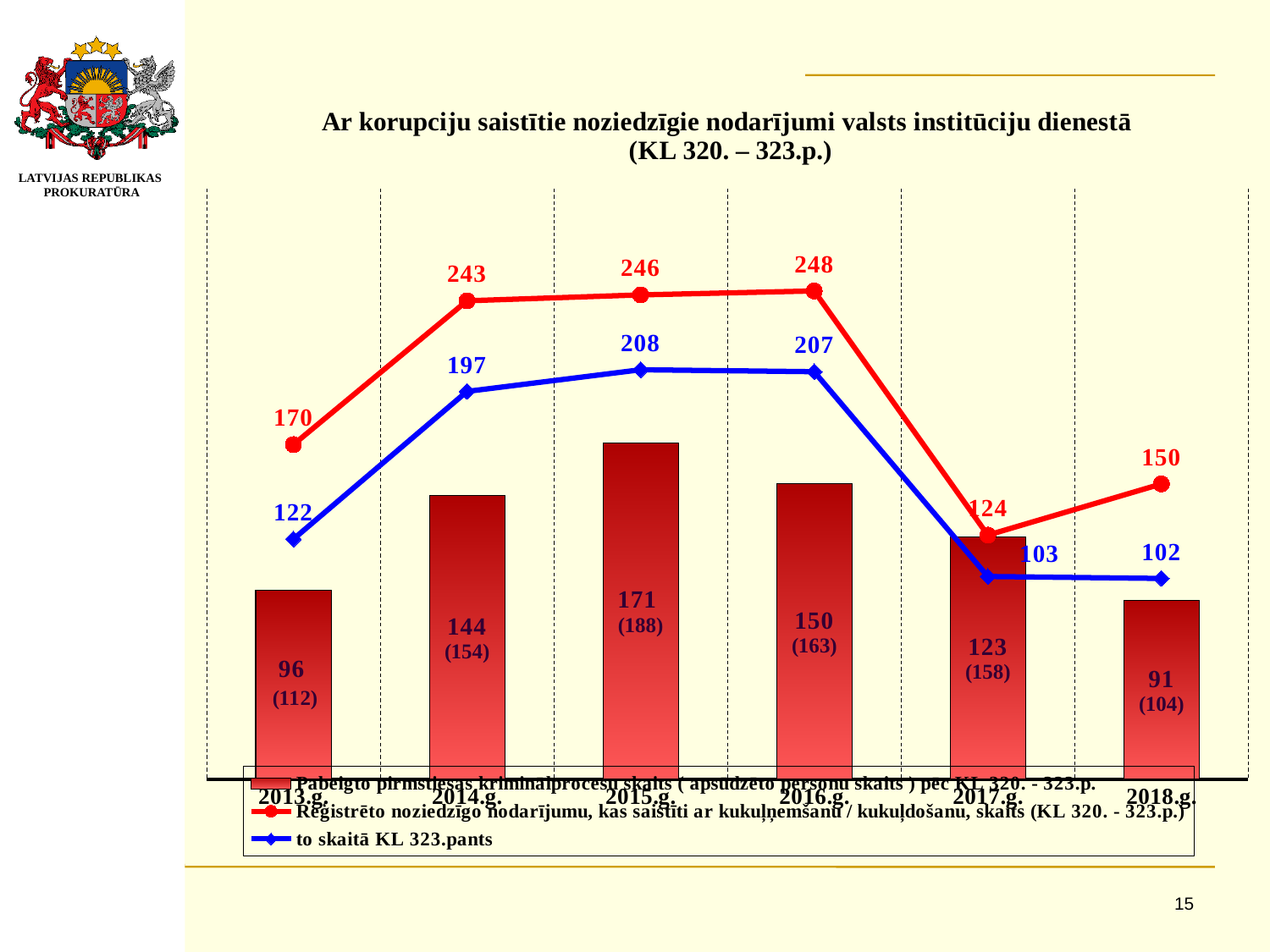
Which is larger: the blue line value for 2015.g. or for 2016.g.? 2015.g. What is the bar value (completed pre-trial criminal proceedings) for 2015.g.? 171 In which year does the red line reach its highest value? 2016.g. What is the number of accused persons shown in parentheses on the bar for 2017.g.? 158 What is the difference between the red line values for 2016.g. and 2017.g.? 124 What is the value of the red line (registered criminal offences related to bribery) for 2016.g.? 248 How many years are shown on the x axis? 6 What is the value of the blue line (to skaitā KL 323.pants) for 2014.g.? 197 What kind of chart is this? Combined bar and line chart How many series does the legend list? 3 Does the blue line rise or fall from 2016.g. to 2017.g.? Fall In which year is the bar value lowest? 2018.g.